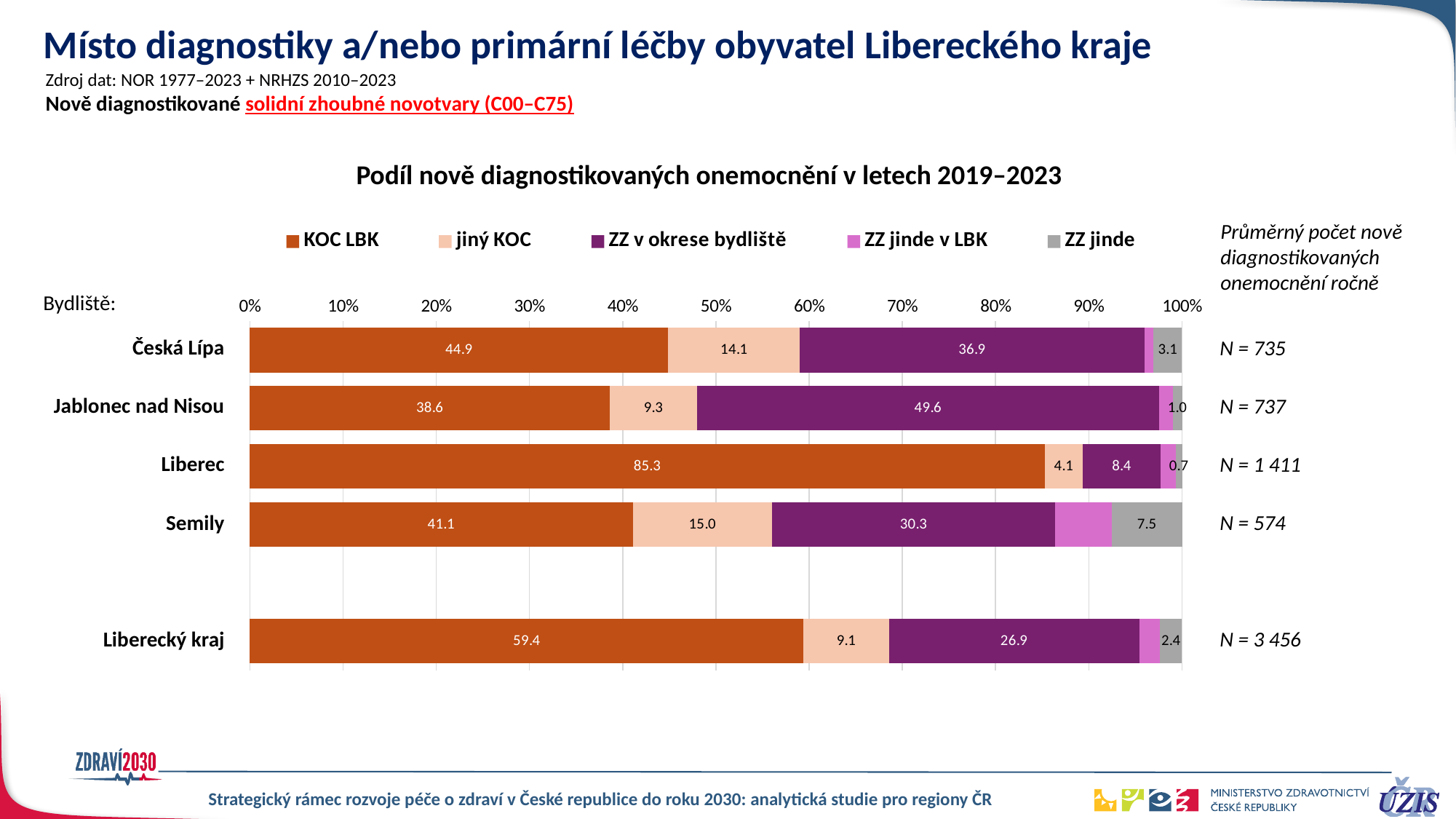
What is the title of the chart? Podíl nově diagnostikovaných onemocnění v letech 2019–2023 Which residence category has the highest KOC LBK value? Liberec What is the KOC LBK value for Liberec? 85.3 What kind of chart is shown on the slide? stacked bar chart Which is larger: the ZZ v okrese bydliště value for Česká Lípa or for Semily? Česká Lípa What is the difference between the jiný KOC values for Semily and Česká Lípa? 0.9 What is the jiný KOC value for Liberecký kraj? 9.1 Which residence category has the lowest ZZ jinde value? Liberec What is the ZZ jinde value for Semily? 7.5 How many residence categories (Bydliště) are plotted on the chart? 5 What is the ZZ v okrese bydliště value for Jablonec nad Nisou? 49.6 How many series does the legend list? 5